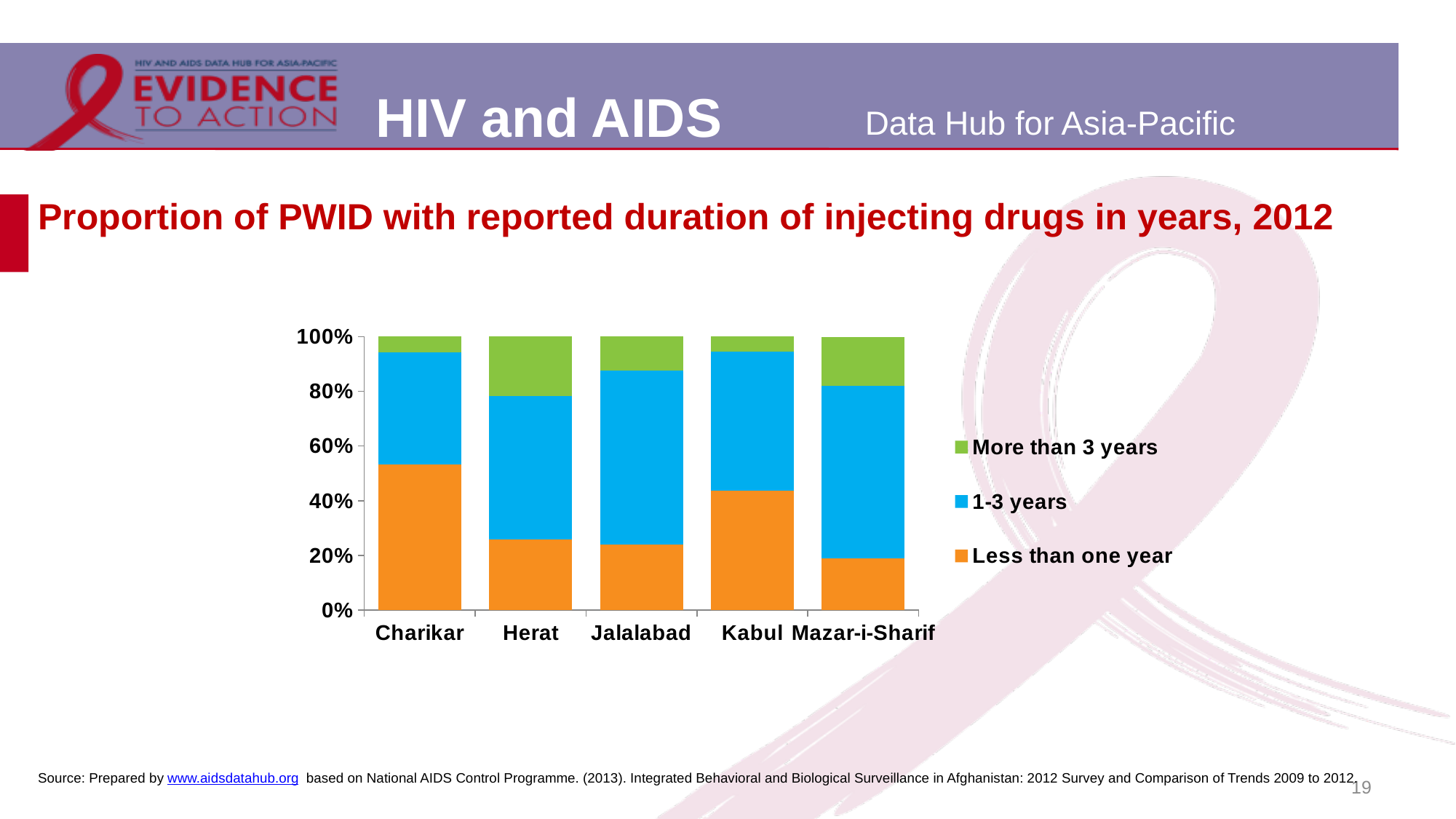
Is the 'Less than one year' proportion for Charikar greater or less than 40%? greater Which city has the largest proportion of PWID injecting for less than one year? Charikar How many series does the chart's legend list? 3 Which city has a larger 'Less than one year' proportion, Charikar or Herat? Charikar What is the total height of each stacked bar in the chart? 100% Which city has a larger 'More than 3 years' proportion, Herat or Kabul? Herat Which colour represents the '1-3 years' series in the chart? Blue How many cities are shown on the x axis of the chart? 5 Is the 'Less than one year' proportion for Herat greater or less than 40%? less Is the 'Less than one year' proportion for Kabul greater or less than 40%? greater Which city has the smallest proportion of PWID injecting for less than one year? Mazar-i-Sharif What kind of chart is shown on the slide? Stacked bar chart